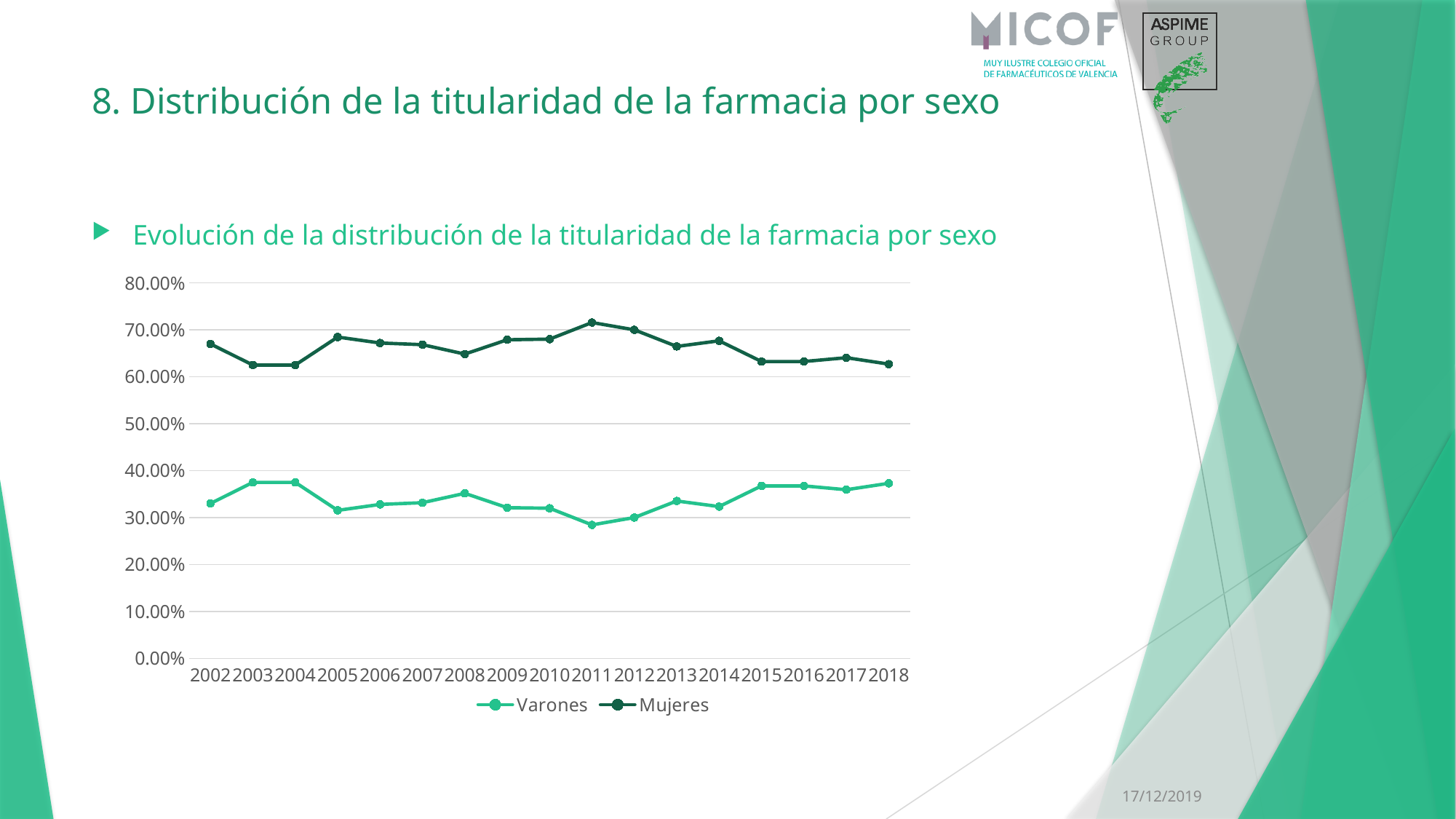
How many years are plotted along the x axis? 17 In which year does the Mujeres series reach its highest value? 2011 In which year does the Varones series reach its lowest value? 2011 Is the value for Mujeres in 2003 greater or less than 60.00%? greater Is the value for Varones in 2003 greater or less than 40.00%? less Is the value for Varones in 2011 greater or less than 30.00%? less What are the two series named in the legend? Varones and Mujeres Which series has the larger value in 2010, Varones or Mujeres? Mujeres What is the first year shown on the x axis? 2002 How many series does the legend list? 2 What kind of chart is shown on the slide? line chart